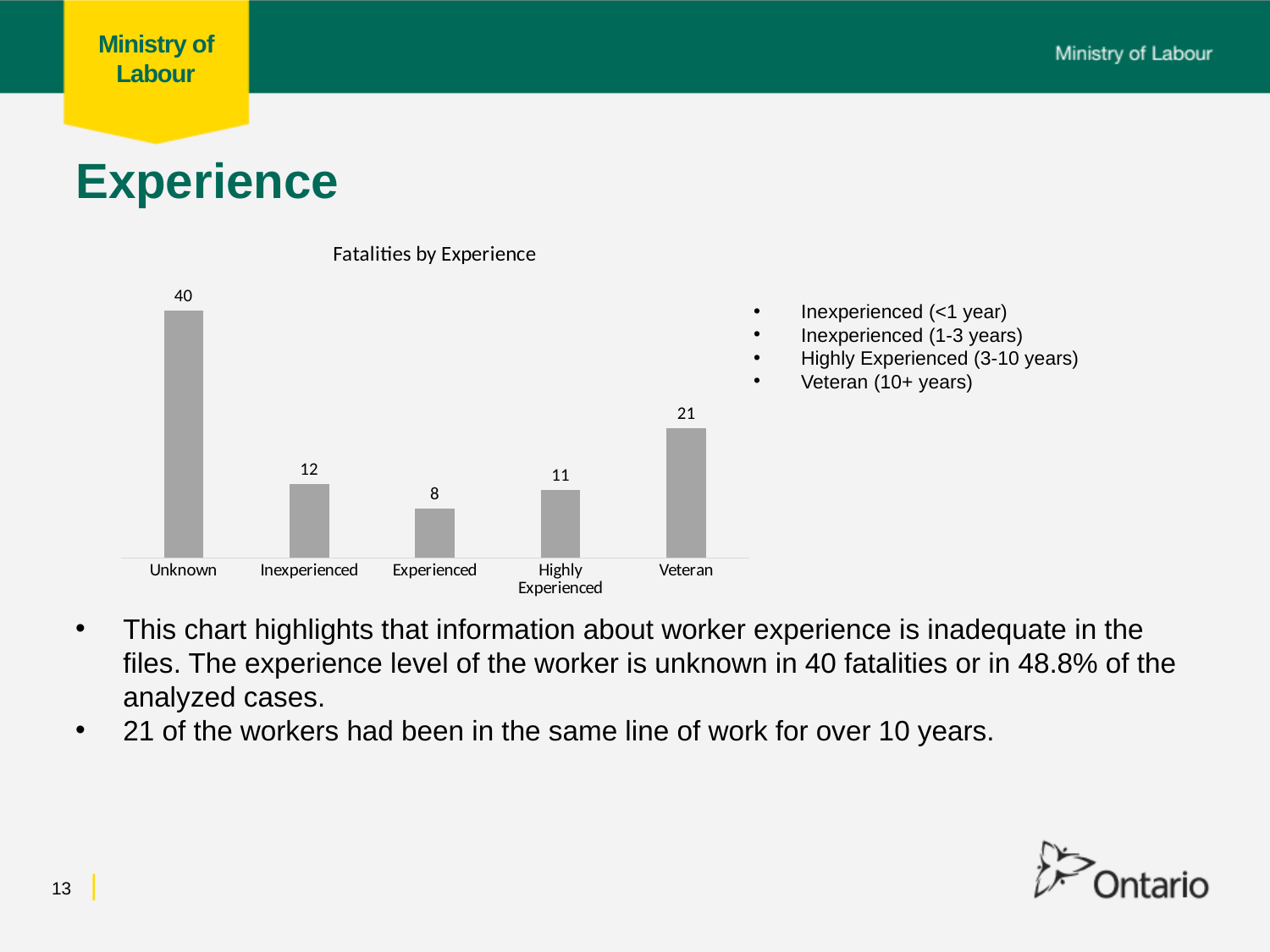
What is the value for Highly Experienced in the Fatalities by Experience chart? 11 What is the difference between the values for Unknown and Veteran in the Fatalities by Experience chart? 19 What is the value for Veteran in the Fatalities by Experience chart? 21 What is the value for Experienced in the Fatalities by Experience chart? 8 Which is larger in the Fatalities by Experience chart, Inexperienced or Highly Experienced? Inexperienced Which category has the lowest value in the Fatalities by Experience chart? Experienced How many categories are shown in the Fatalities by Experience chart? 5 What is the difference between the values for Inexperienced and Experienced in the Fatalities by Experience chart? 4 Which category has the highest value in the Fatalities by Experience chart? Unknown What is the value for Unknown in the Fatalities by Experience chart? 40 What is the title of the chart on the slide? Fatalities by Experience What kind of chart is the Fatalities by Experience chart? Bar chart